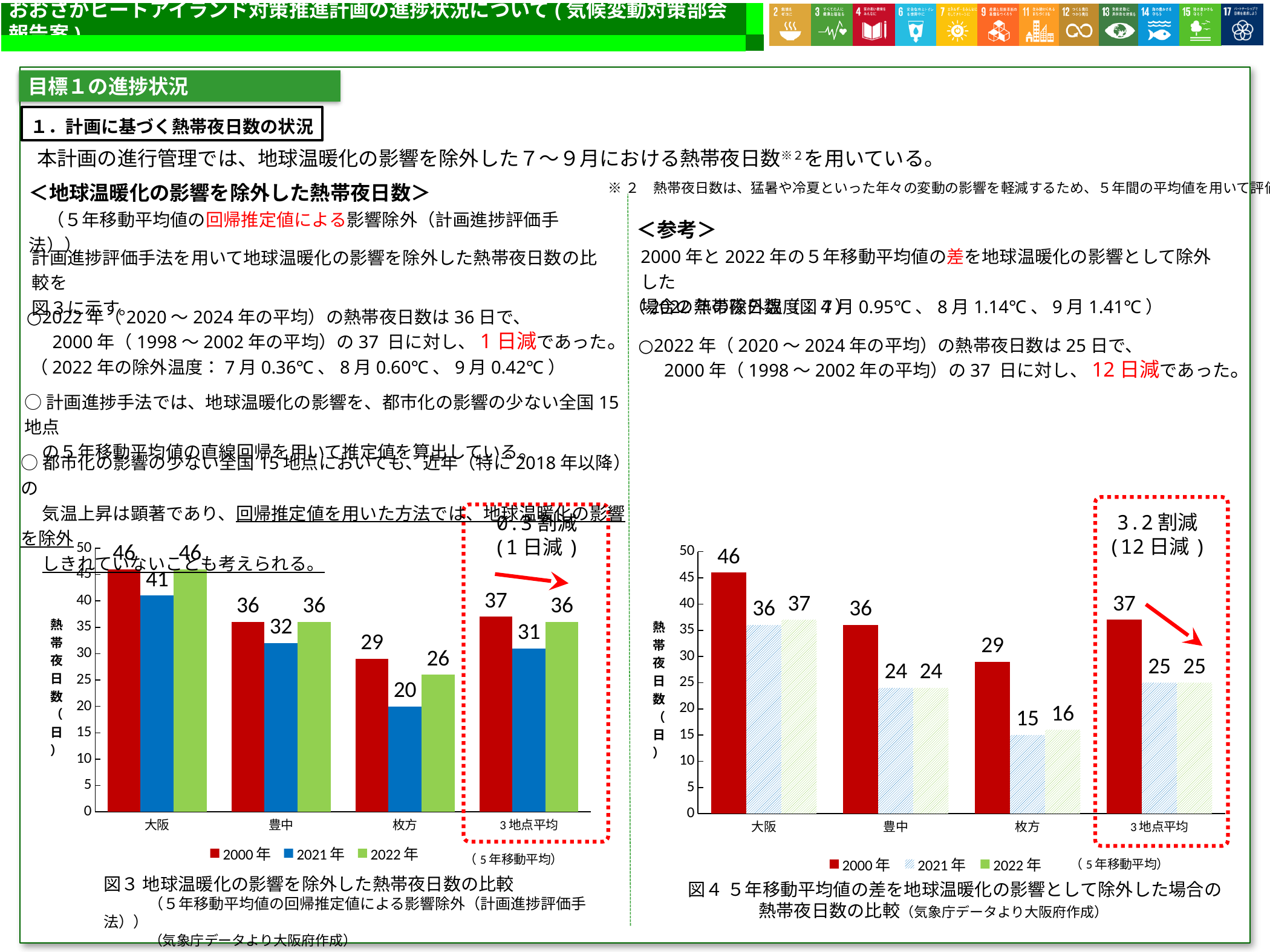
In the right chart (図4), which is larger for 枚方: the 2000年 value or the 2021年 value? 2000年 In the left chart (図3), which category has the lowest value in the 2021年 series? 枚方 In the right chart (図4), what is the value for 豊中 in the 2021年 series? 24 How many categories are shown on the x axis of the left chart (図3)? 4 In the left chart (図3), what is the difference between the 2000年 and 2021年 values for 大阪? 5 In the left chart (図3), what is the value for 3地点平均 in the 2022年 series? 36 In the right chart (図4), what is the value for 3地点平均 in the 2022年 series? 25 In the right chart (図4), which category has the highest value in the 2000年 series? 大阪 In the right chart (図4), what is the difference between the 2000年 and 2022年 values for 3地点平均? 12 What kind of chart is the left chart (図3)? Bar chart How many series does the legend of the right chart (図4) list? 3 In the left chart (図3), what is the value for 枚方 in the 2021年 series? 20